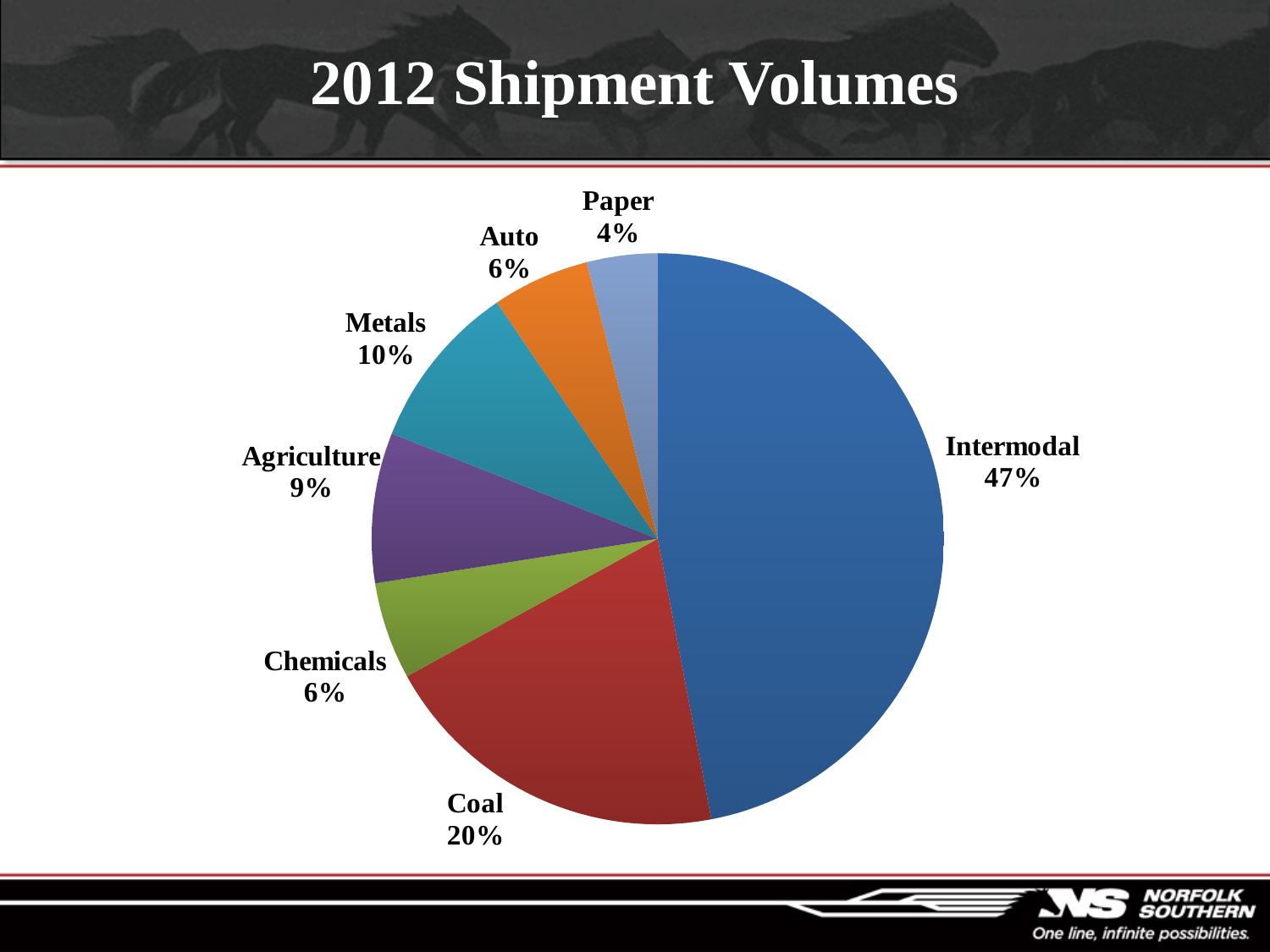
What is the value shown for Agriculture? 9% What is the title of the chart? 2012 Shipment Volumes What is the difference between the Intermodal and Coal shares? 27% What is the value shown for Metals? 10% Which category has the smallest slice of the pie? Paper How many categories are shown in the pie chart? 7 What share of shipment volumes is Coal? 20% What type of chart is shown on the slide? pie chart What is the combined share of Auto and Chemicals? 12% Which is larger, the share for Metals or the share for Auto? Metals Which category has the largest slice of the pie? Intermodal What share of shipment volumes is Intermodal? 47%